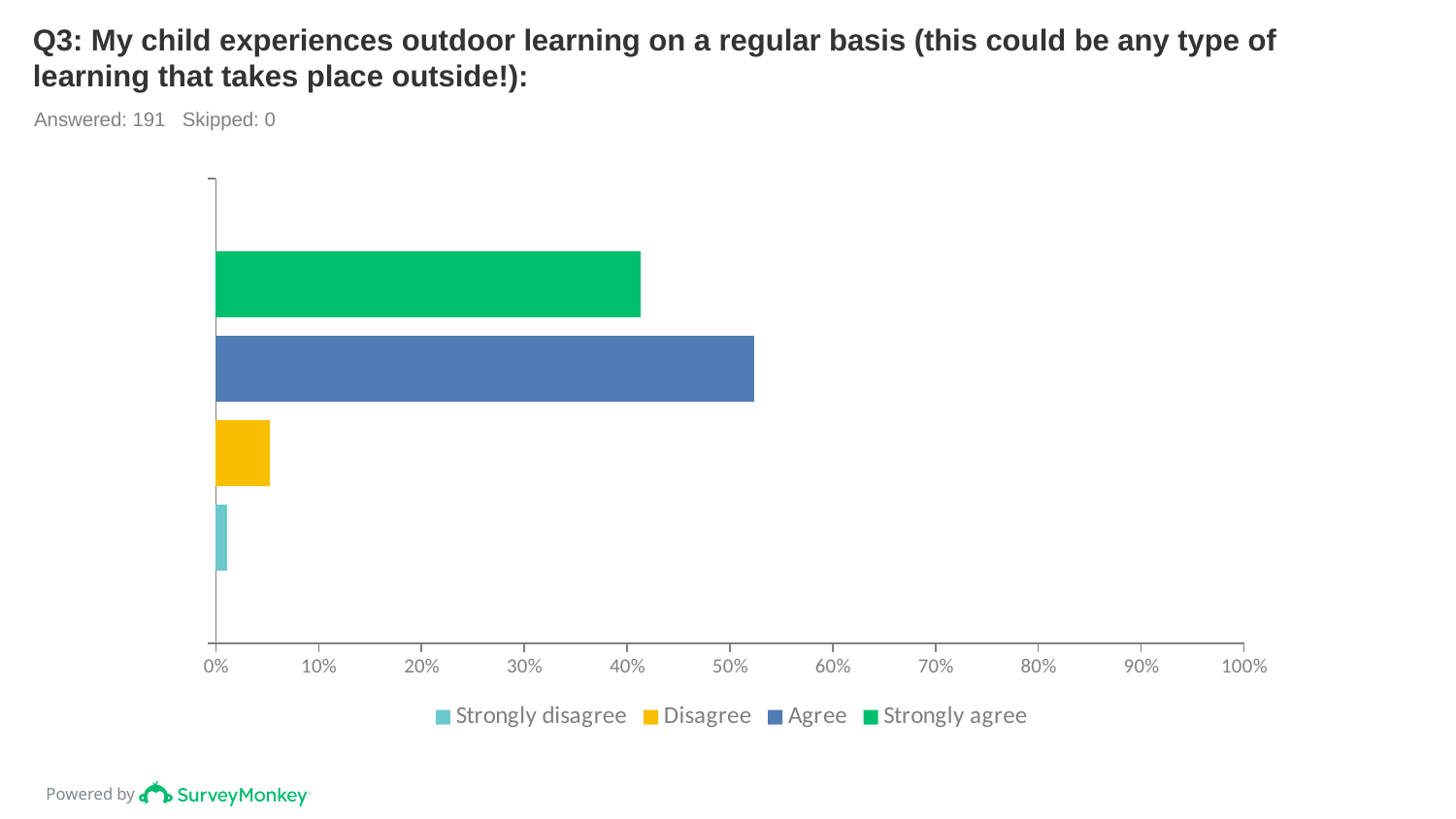
Is the value for Strongly agree greater or less than 40%? greater Is the value for Disagree greater or less than 10%? less Is the value for Agree greater or less than 50%? greater Which is larger, the value for Agree or the value for Strongly agree? Agree How many series does the legend list? 4 What colour is the bar for Strongly agree? green Which is larger, the value for Disagree or the value for Strongly disagree? Disagree How many bars are plotted in the chart? 4 What kind of chart is shown on the slide? bar chart Which response option has the highest value? Agree Which response option has the lowest value? Strongly disagree